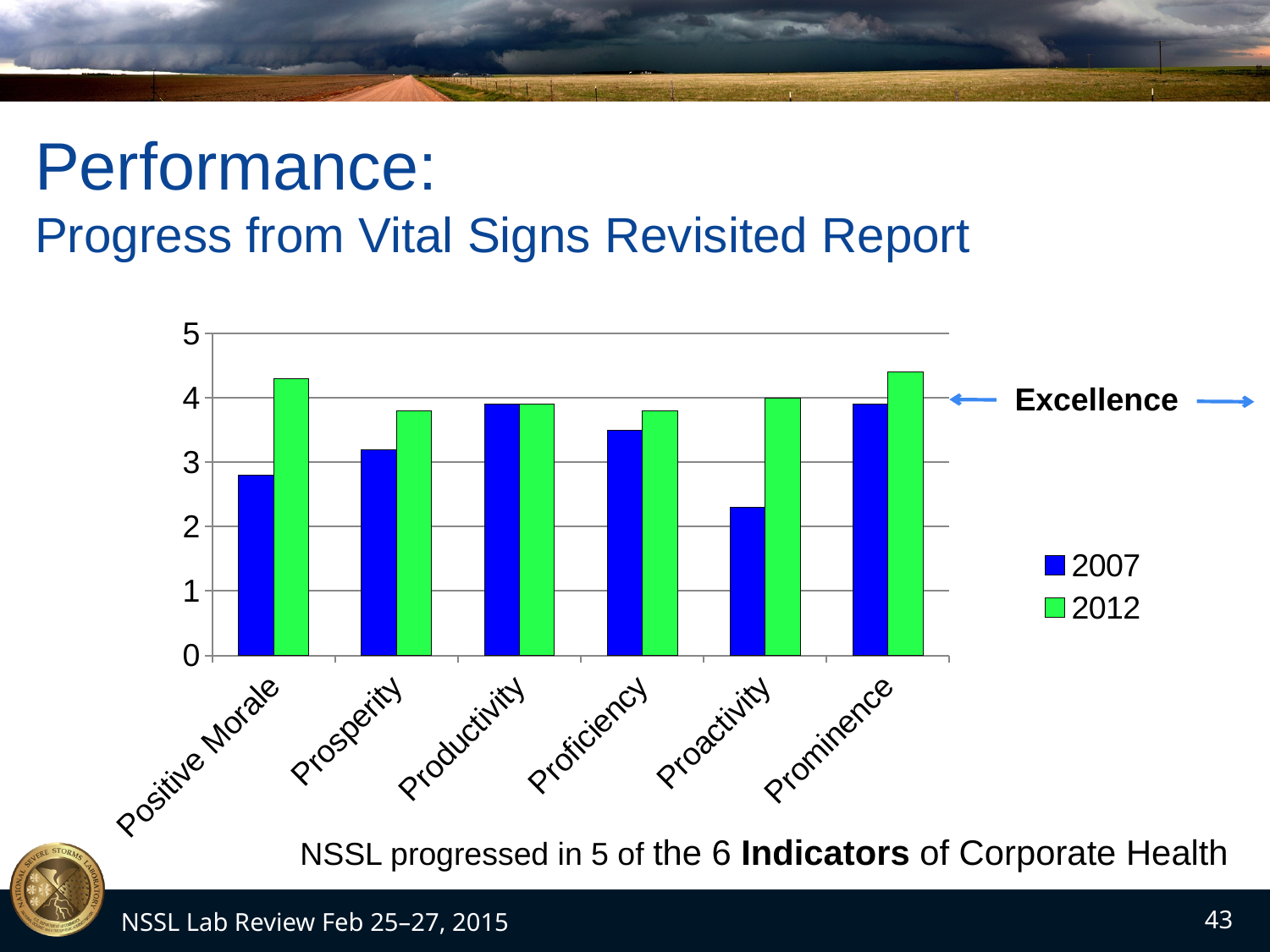
How many categories (indicators) are shown on the x axis of the chart? 6 What label is written next to the horizontal arrow line at the level of 4 on the chart? Excellence Is the 2012 value for Prosperity greater or less than 4? less Which category has the lowest 2007 value? Proactivity Is the 2012 value for Positive Morale greater or less than 4? greater Is the 2007 value for Proactivity greater or less than 3? less What kind of chart is shown on the slide? bar chart How many series does the chart legend list? 2 Which two years are listed in the chart legend? 2007 and 2012 For Proactivity, which series has the larger value, 2007 or 2012? 2012 Which category has the highest 2012 value? Prominence